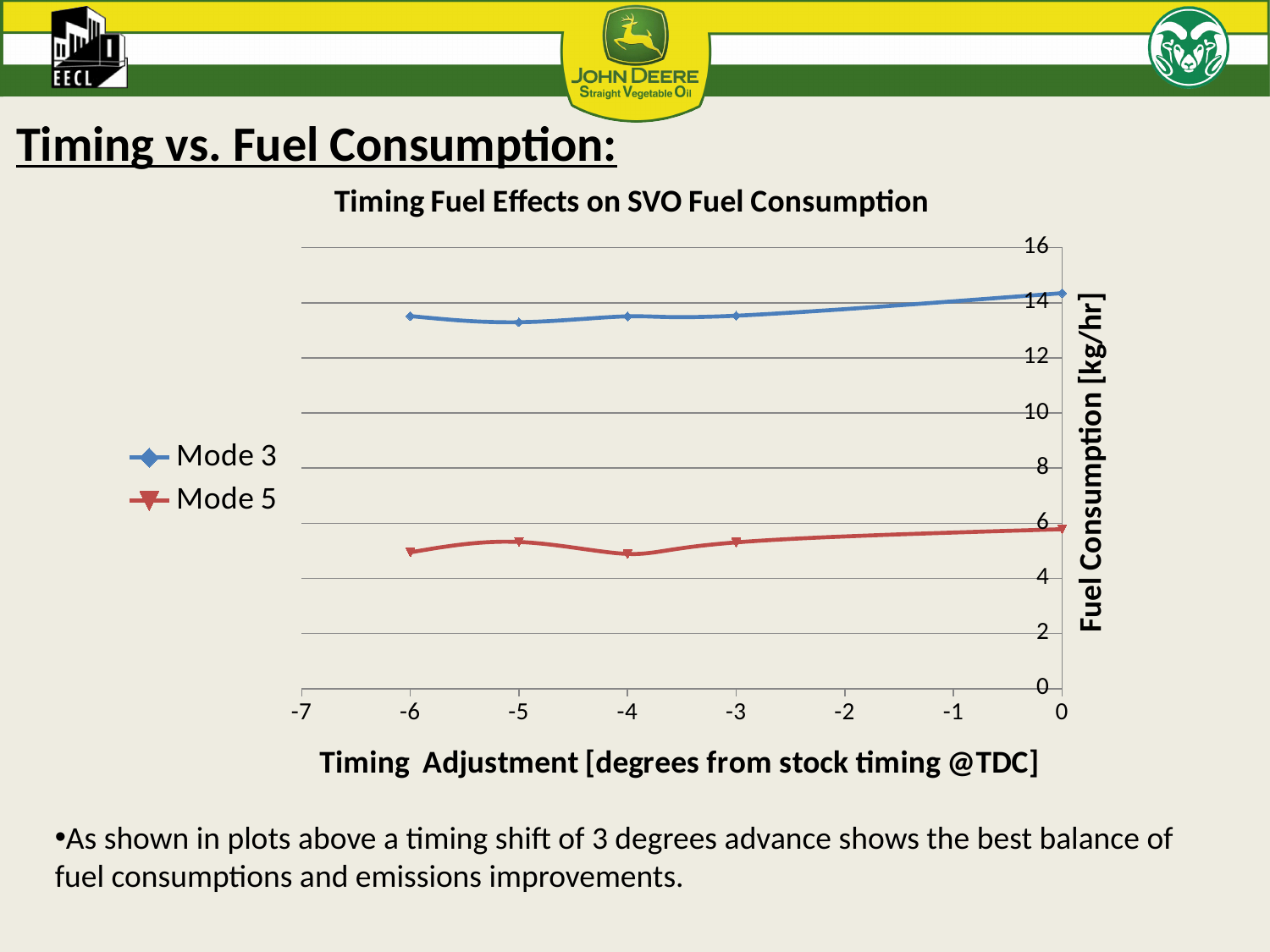
Is the Mode 3 value at a timing adjustment of 0 greater or less than 14? greater What are the names of the two series in the legend? Mode 3 and Mode 5 At a timing adjustment of -3, which series has the higher fuel consumption, Mode 3 or Mode 5? Mode 3 Is the Mode 3 value at a timing adjustment of -6 greater or less than 12? greater At which timing adjustment does the Mode 3 series reach its highest fuel consumption? 0 How many data points are plotted for the Mode 3 series? 5 Is the Mode 5 value at a timing adjustment of 0 greater or less than 4? greater What is the title of the chart? Timing Fuel Effects on SVO Fuel Consumption How many series does the legend list? 2 Does the Mode 3 fuel consumption rise or fall overall from a timing adjustment of -6 to 0? rise What kind of chart is shown on the slide? Line chart